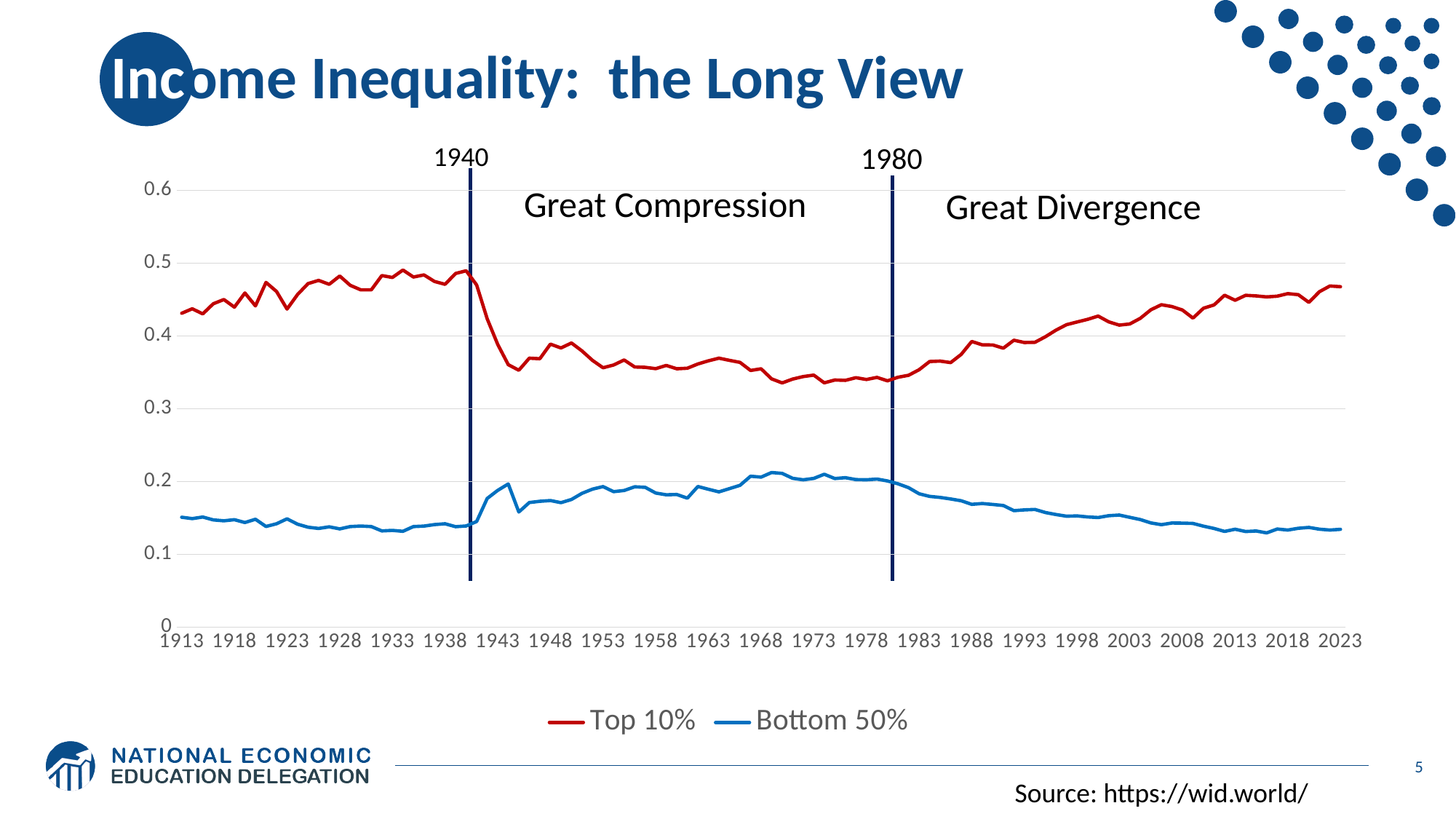
Which series has the larger value in 1913, Top 10% or Bottom 50%? Top 10% Does the Bottom 50% series rise or fall between 1980 and 2023? fall Is the value for Top 10% in 2023 greater or less than 0.5? less Does the Top 10% series rise or fall between 1940 and 1980? fall Is the value for Bottom 50% in 1913 greater or less than 0.2? less What is the title of the slide containing the chart? Income Inequality: the Long View What are the two series named in the legend? Top 10% and Bottom 50% Is the value for Top 10% in 1913 greater or less than 0.4? greater What kind of chart is shown on the slide? line chart How many series does the legend list? 2